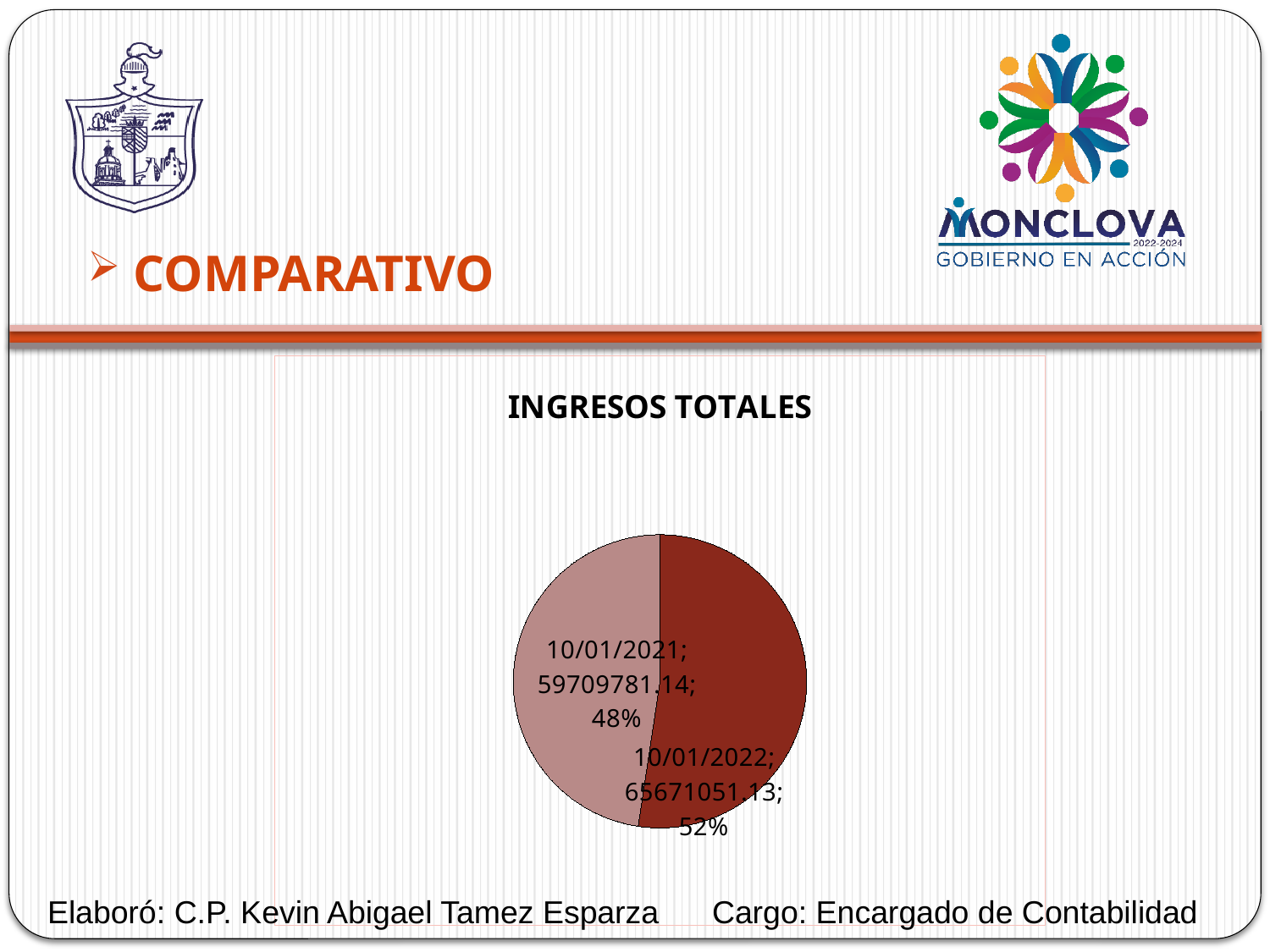
How many slices does the pie chart have? 2 What is the title of the chart? INGRESOS TOTALES Which date has the larger slice in the INGRESOS TOTALES pie chart? 10/01/2022 What is the value for 10/01/2021 in the INGRESOS TOTALES chart? 59709781.14 What is the difference between the values for 10/01/2022 and 10/01/2021? 5961269.99 What is the total of the two values shown in the pie chart? 125380832.27 What type of chart is shown on the slide? pie chart What share of the pie does the 10/01/2021 slice represent? 48% What share of the pie does the 10/01/2022 slice represent? 52% Which date has the smaller slice in the INGRESOS TOTALES pie chart? 10/01/2021 What is the value for 10/01/2022 in the INGRESOS TOTALES chart? 65671051.13 Is the value for 10/01/2022 larger or smaller than the value for 10/01/2021? larger